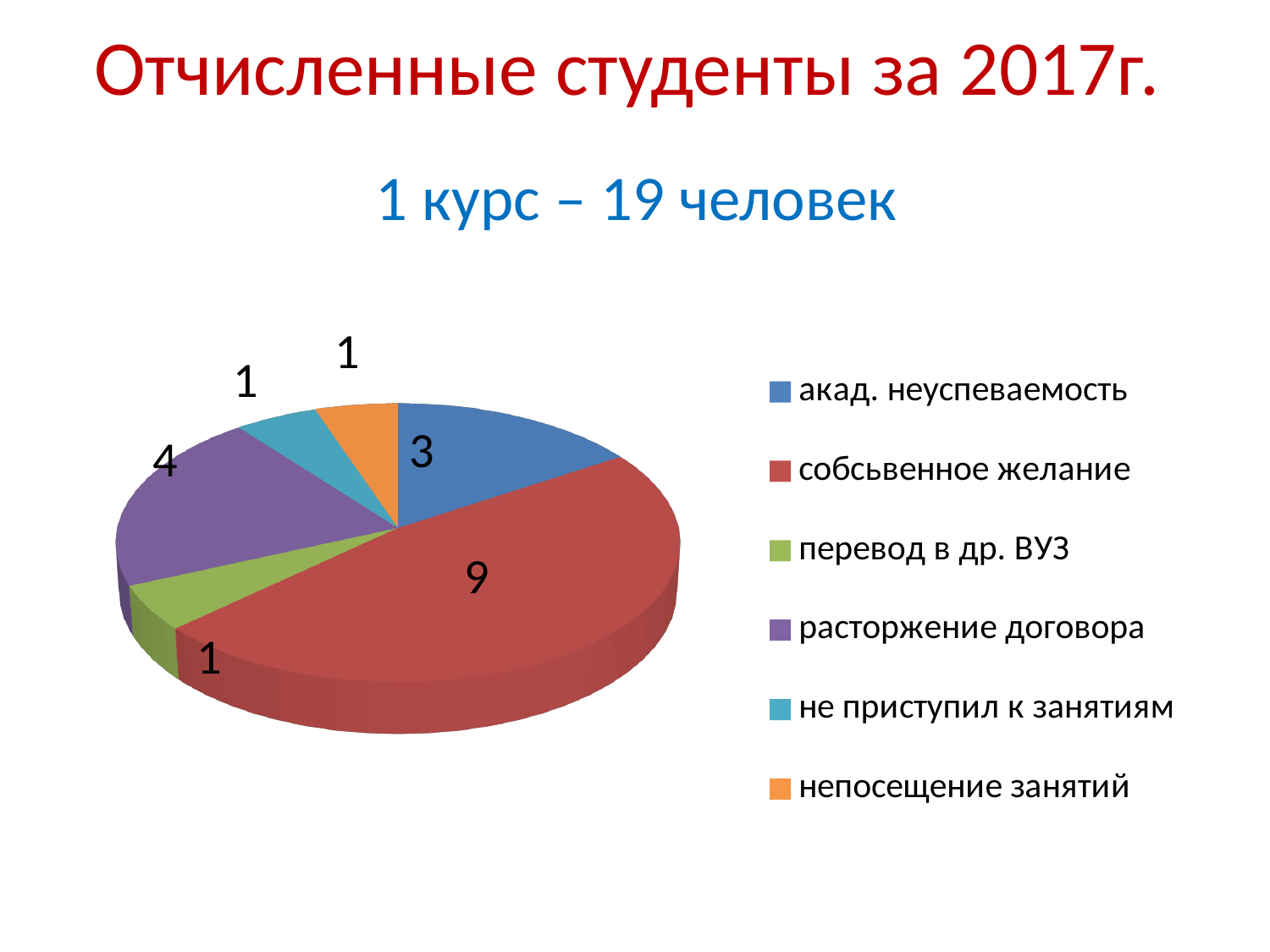
What is the value for собсьвенное желание? 9 How many slices does the pie chart have? 6 What kind of chart is shown on the slide? pie chart How many entries does the legend list? 6 What colour is the slice for непосещение занятий? orange What is the value for перевод в др. ВУЗ? 1 What is the difference between the values for собсьвенное желание and расторжение договора? 5 What is the value for акад. неуспеваемость? 3 Which category has the largest slice? собсьвенное желание What is the total of all slices in the pie chart? 19 Which is larger, the value for акад. неуспеваемость or the value for расторжение договора? расторжение договора What is the value for расторжение договора? 4